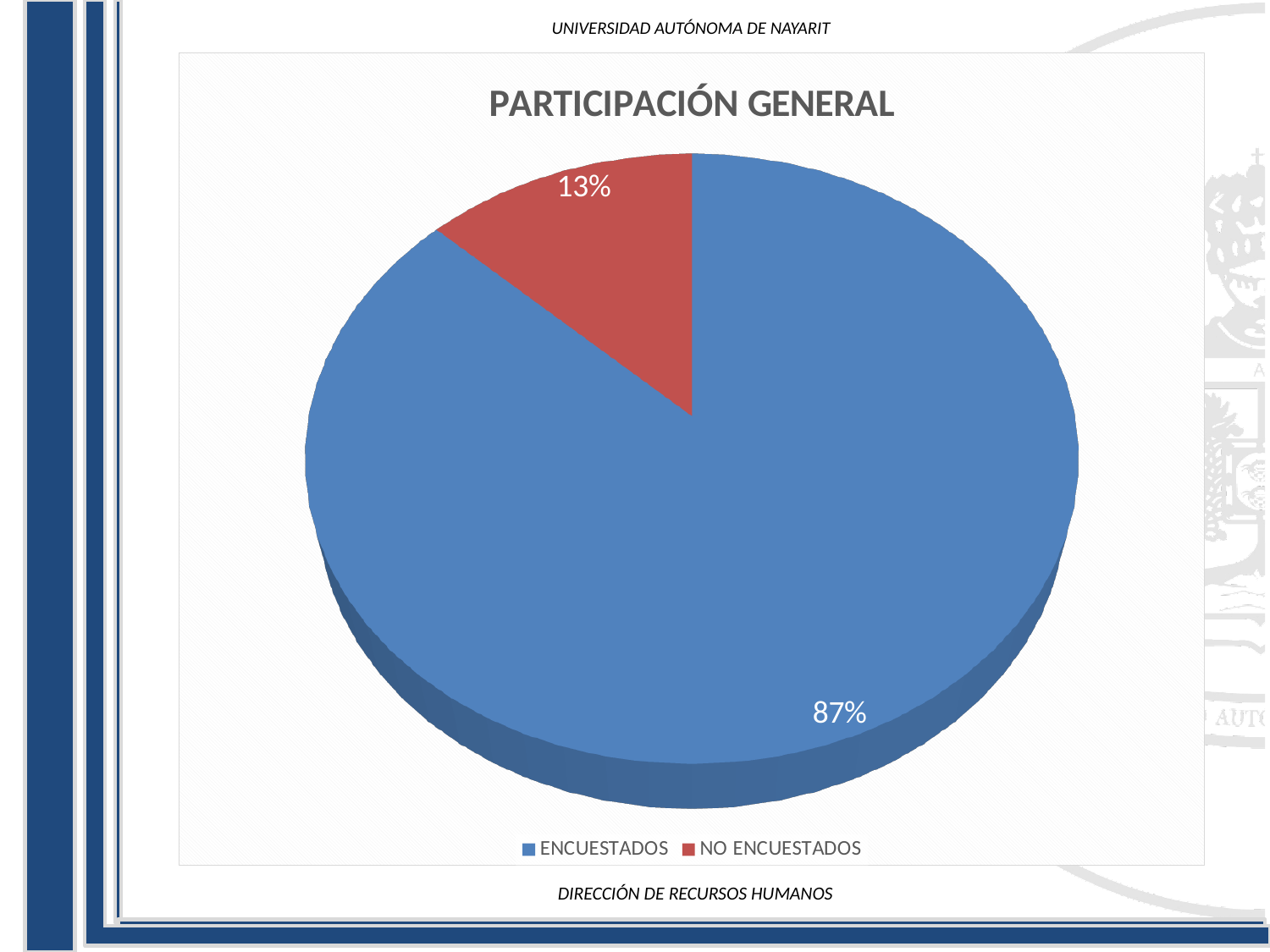
How many entries does the legend list? 2 Which is larger, the share for ENCUESTADOS or the share for NO ENCUESTADOS? ENCUESTADOS What share of the pie does ENCUESTADOS represent? 87% What is the title of the chart? PARTICIPACIÓN GENERAL What colour is the NO ENCUESTADOS slice? red What share of the pie does NO ENCUESTADOS represent? 13% What is the difference in percentage points between ENCUESTADOS and NO ENCUESTADOS? 74 percentage points What kind of chart is shown on the slide? pie chart Which category has the largest slice of the pie? ENCUESTADOS How many categories does the pie chart show? 2 Which category has the smallest slice of the pie? NO ENCUESTADOS